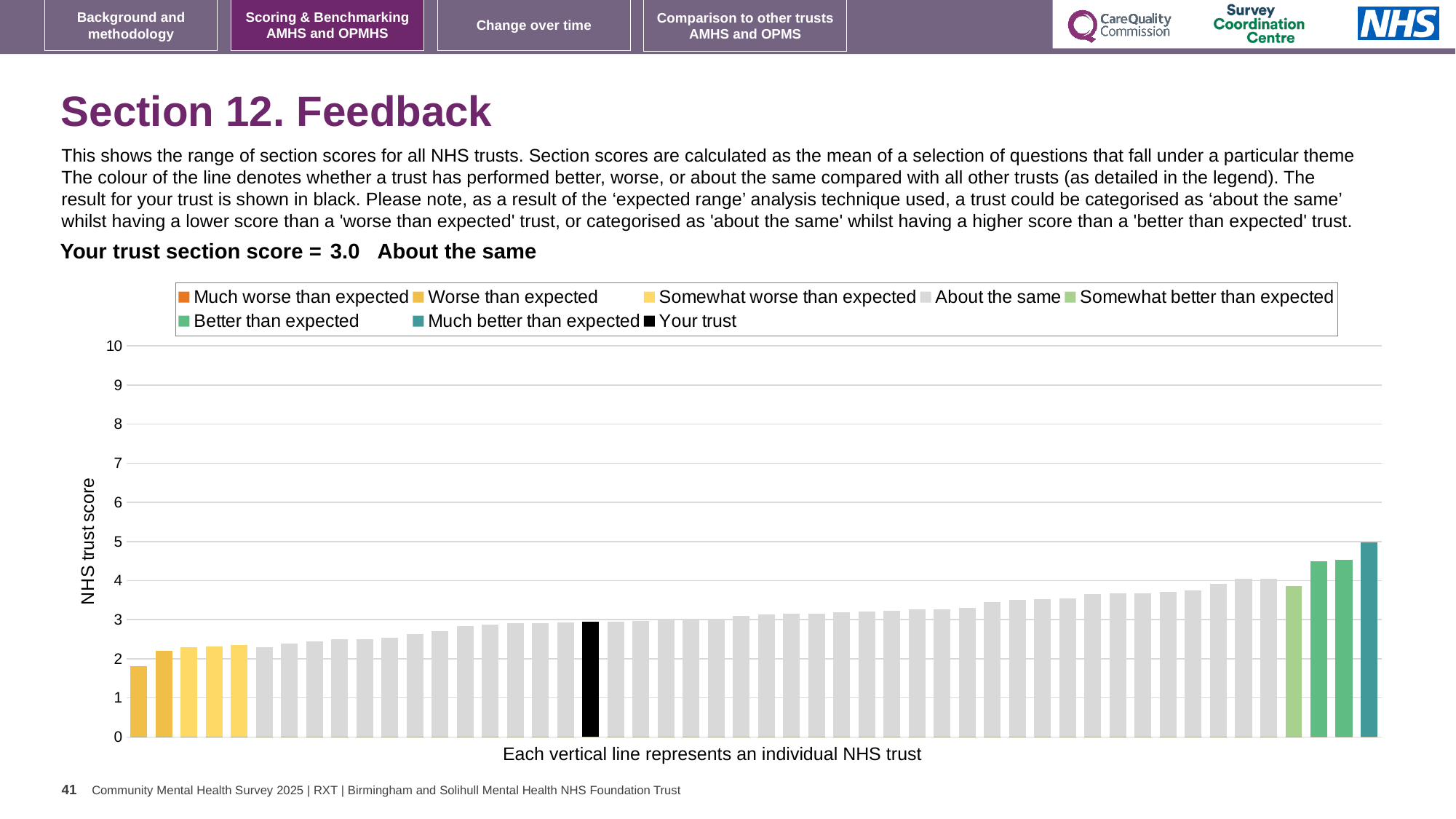
Which is larger: the value for your trust (black bar) or the value of the leftmost bar? Your trust How many entries does the chart legend list? 8 What kind of chart is shown on the slide? Bar chart What is the section score for your trust? 3.0 Is the value of the highest bar greater or less than 4? greater Which legend category does the highest bar belong to? Much better than expected What is the label on the y axis of the chart? NHS trust score Do the bar values rise or fall from left to right along the x axis? Rise Is the value for your trust (black bar) greater or less than 4? less How many bars are coloured as 'Better than expected' (mid green)? 2 Which category is your trust placed in for this section? About the same Is the value of the lowest bar greater or less than 2? less